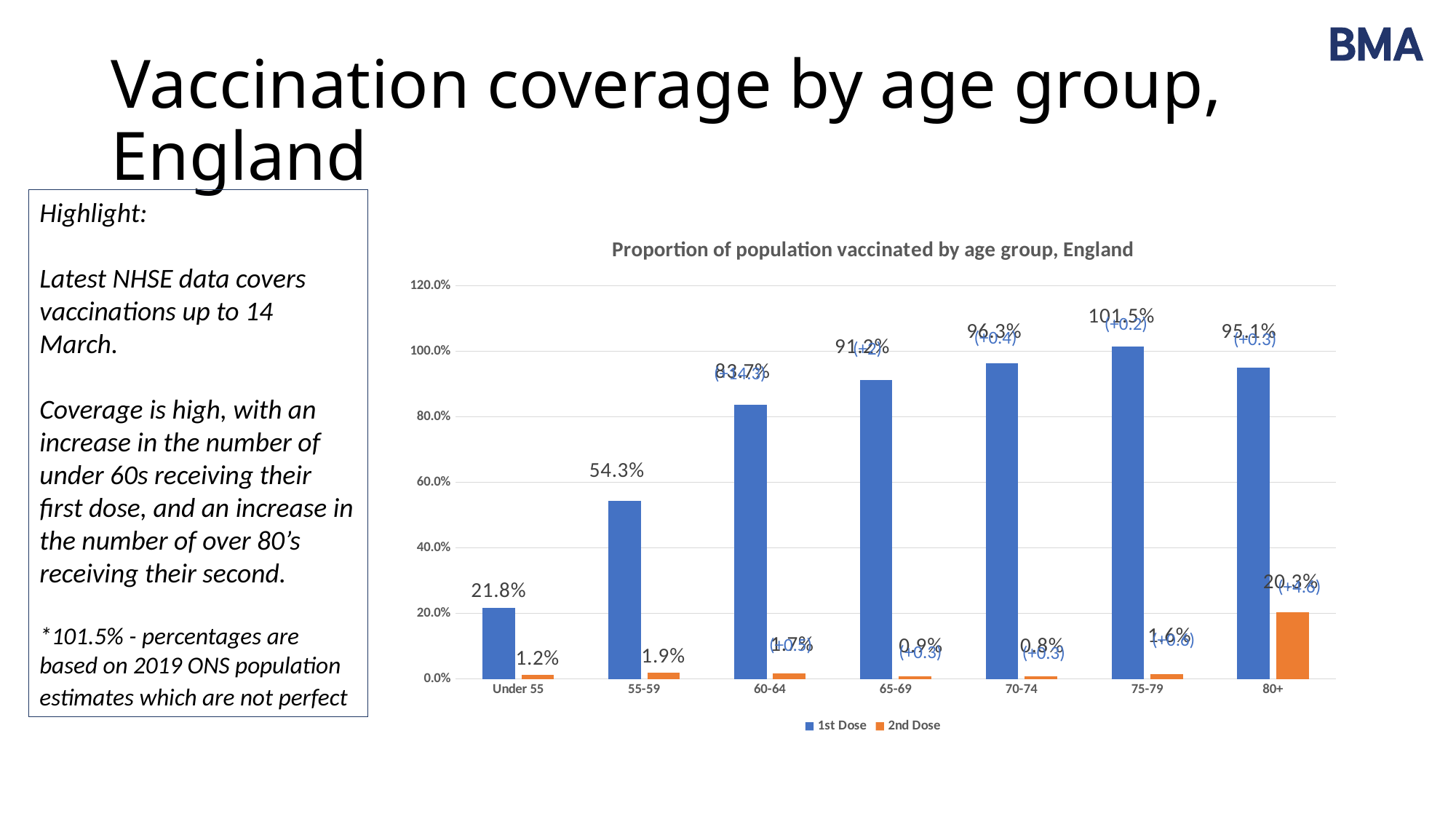
What is the difference between the 1st Dose values for 75-79 and 80+? 6.4 percentage points Which age group has the lowest 1st Dose value? Under 55 Which age group has the highest 2nd Dose value? 80+ Is the 1st Dose value for 65-69 greater or less than 80%? greater What is the 2nd Dose value for the 80+ age group? 20.3% What is the 1st Dose value for the 55-59 age group? 54.3% Which has the larger 1st Dose value, 70-74 or 80+? 70-74 What kind of chart is shown on the slide? bar chart What is the 1st Dose value for the Under 55 age group? 21.8% How many series does the legend list? 2 How many age groups are shown on the x axis? 7 Which age group has the highest 1st Dose value? 75-79